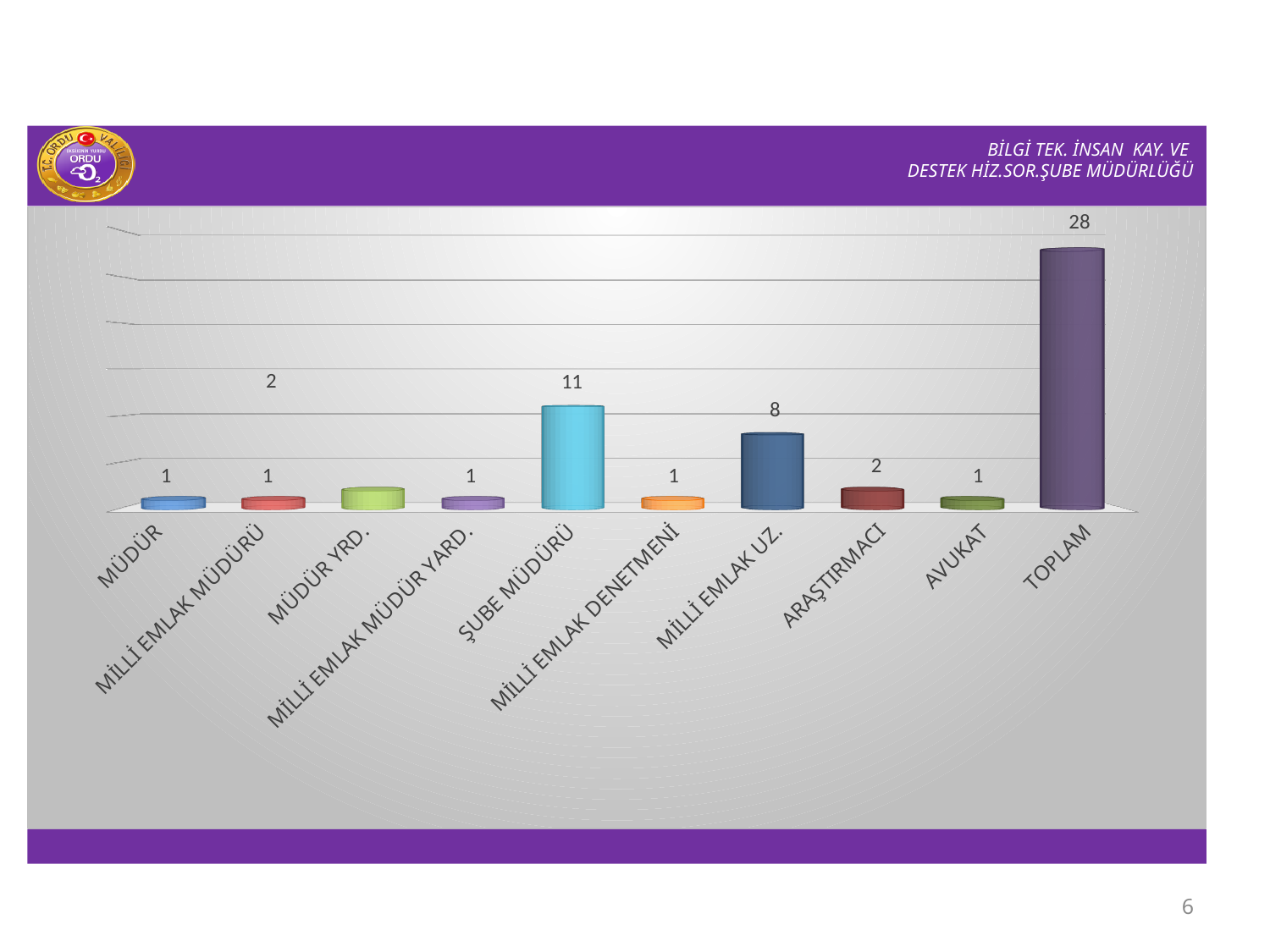
What is the difference between the values for ŞUBE MÜDÜRÜ and MİLLİ EMLAK UZ.? 3 How many categories are shown on the x axis? 10 Which is larger, the value for MİLLİ EMLAK UZ. or the value for ARAŞTIRMACI? MİLLİ EMLAK UZ. What is the difference between the values for TOPLAM and ŞUBE MÜDÜRÜ? 17 Excluding TOPLAM, which category has the highest value? ŞUBE MÜDÜRÜ What is the value for AVUKAT? 1 What is the value for TOPLAM? 28 What is the value for ŞUBE MÜDÜRÜ? 11 What is the value for ARAŞTIRMACI? 2 Which category has the highest value? TOPLAM What kind of chart is shown on the slide? Bar chart What is the value for MİLLİ EMLAK UZ.? 8